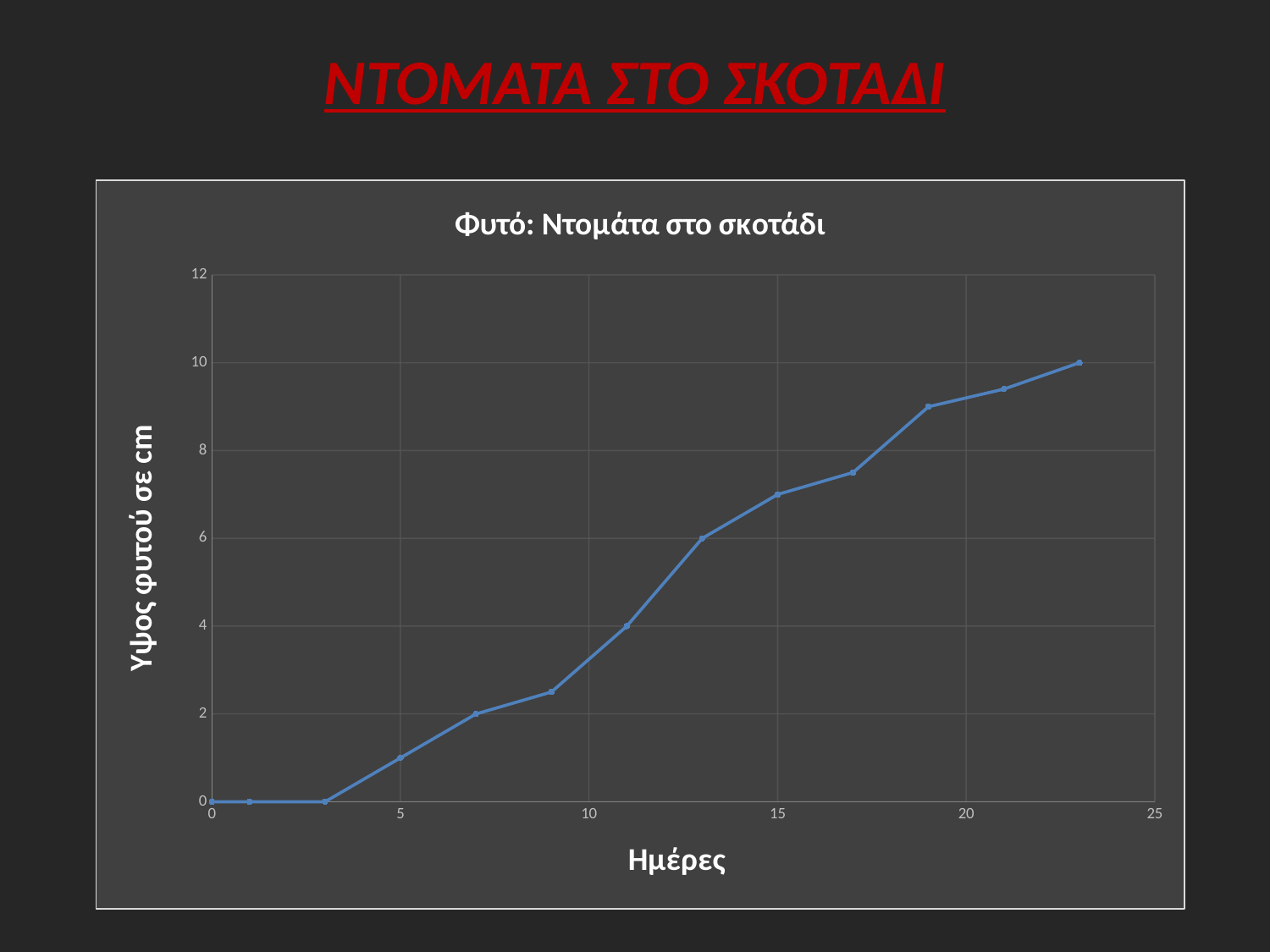
Is the plant height at day 15 greater or less than 6? greater What is the label of the x axis? Ημέρες Which is larger, the plant height at day 5 or at day 15? day 15 How many data points are plotted on the line? 13 Is the plant height at day 15 greater or less than 8? less Does the plant height rise or fall as the days increase? rise What is the highest plant height reached on the chart, in cm? 10 What is the plant height at day 0? 0 What kind of chart is shown on the slide? line chart What is the title of the chart? Φυτό: Ντομάτα στο σκοτάδι Is the plant height at day 5 greater or less than 2? less What is the maximum value shown on the y axis? 12